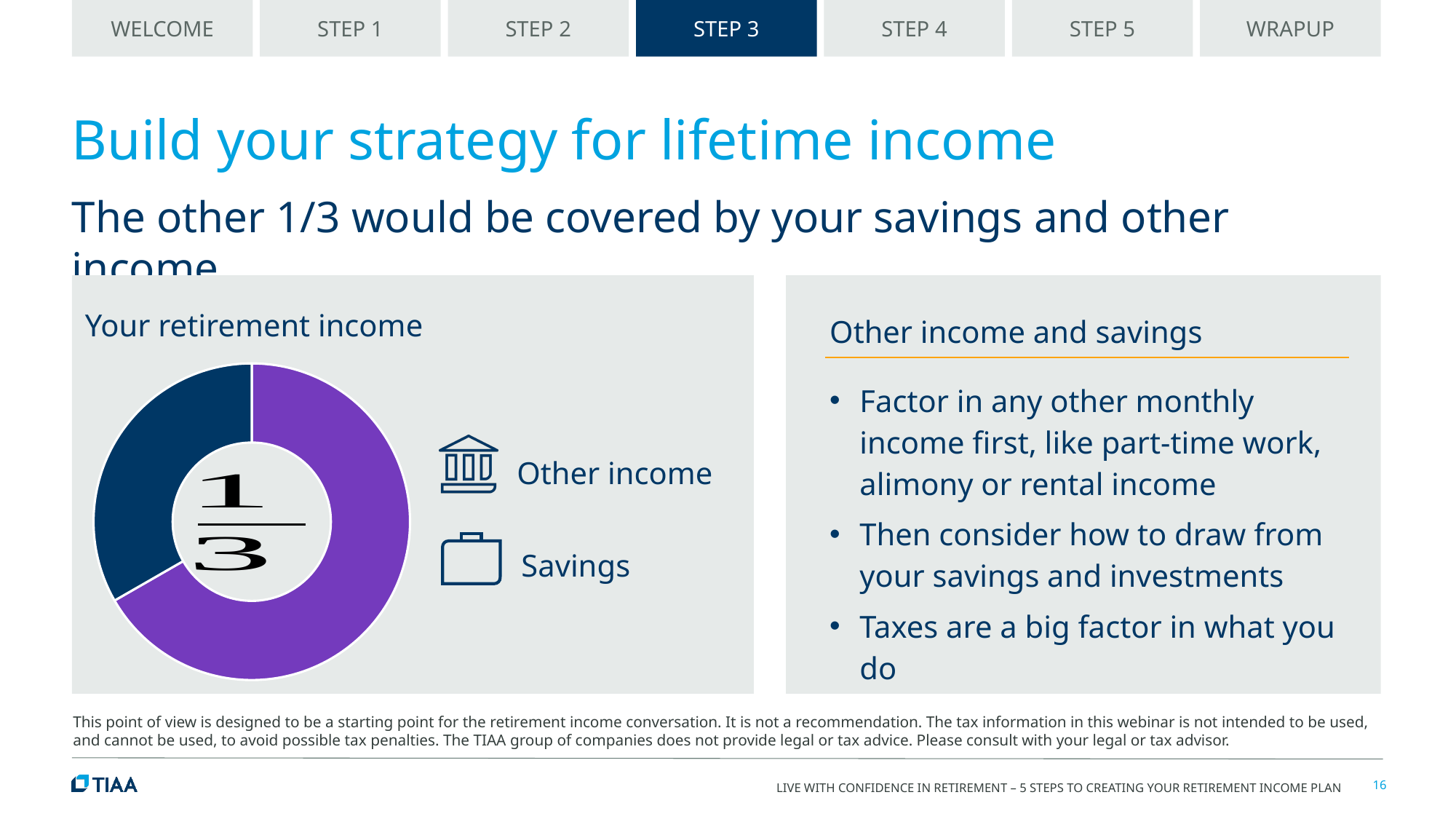
What fraction is printed in the center of the "Your retirement income" chart? 1/3 In the "Your retirement income" chart, which slice is the smallest? The dark blue slice What kind of chart is shown under "Your retirement income"? Pie (donut) chart In the "Your retirement income" chart, which slice is larger, the purple one or the dark blue one? The purple one How many slices does the "Your retirement income" chart have? 2 What is the title of the chart on the left side of the slide? Your retirement income Is the purple slice of the "Your retirement income" chart more or less than half of the chart? More Is the dark blue slice of the "Your retirement income" chart more or less than half of the chart? Less